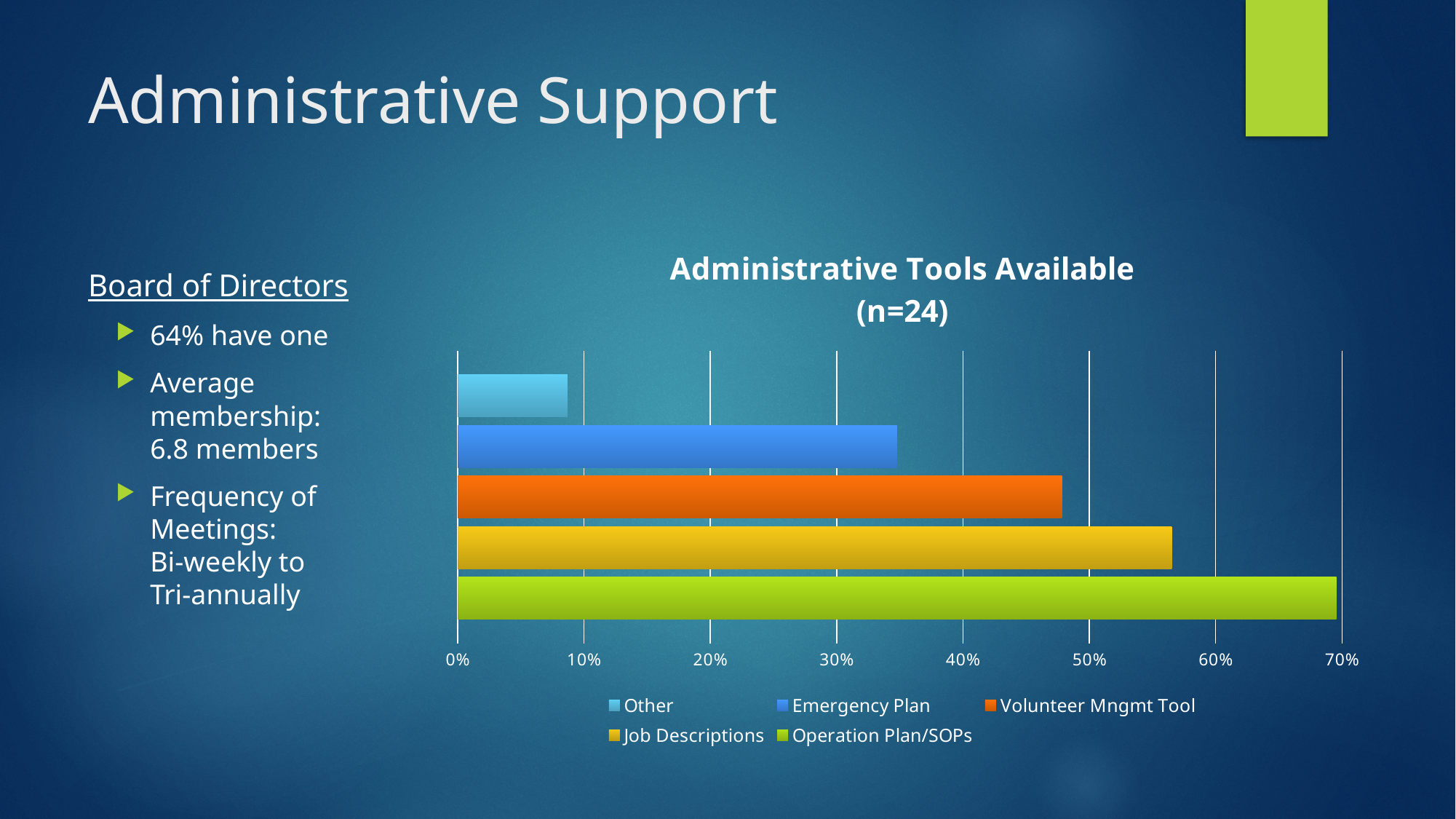
Is the value for Job Descriptions greater or less than 50%? greater Is the value for Other greater or less than 10%? less What kind of chart is shown on the slide? bar chart How many bars are plotted in the chart? 5 What is the title of the chart? Administrative Tools Available (n=24) Which has a larger value, Job Descriptions or Emergency Plan? Job Descriptions Is the value for Emergency Plan greater or less than 30%? greater Which administrative tool has the highest value in the chart? Operation Plan/SOPs How many series does the chart legend list? 5 Which administrative tool has the lowest value in the chart? Other